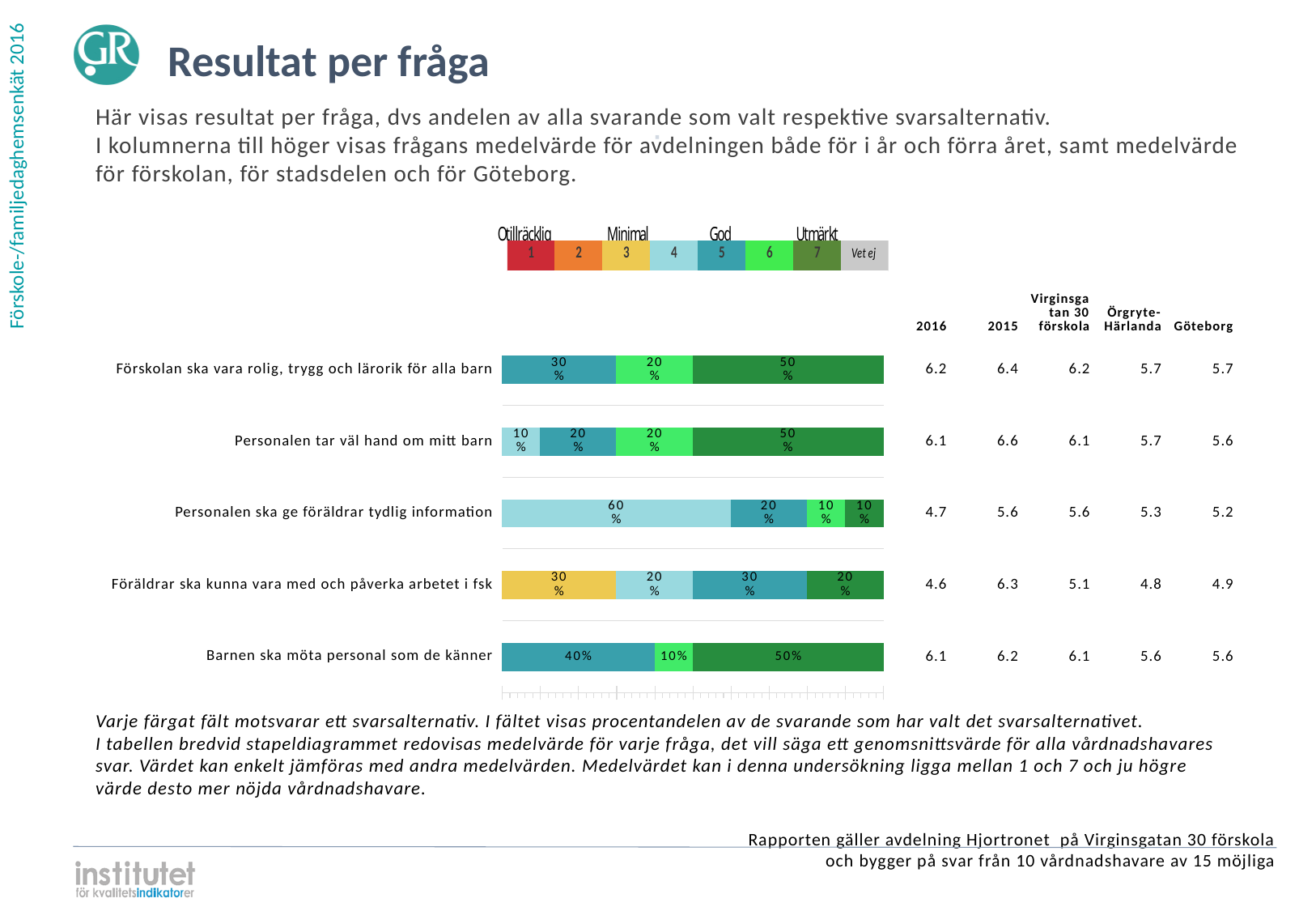
What percentage of respondents chose answer 3 (yellow) for 'Föräldrar ska kunna vara med och påverka arbetet i fsk'? 30% Which is larger for 'Personalen ska ge föräldrar tydlig information': the share for answer 4 or the share for answer 5? Answer 4 How many questions (categories) are shown in the bar chart? 5 What percentage of respondents chose answer 5 (teal) for 'Barnen ska möta personal som de känner'? 40% Which answer option does the dark green colour represent in the legend? 7 How many answer options are shown in the colour legend above the chart, including 'Vet ej'? 8 What percentage of respondents chose answer 7 (dark green) for 'Förskolan ska vara rolig, trygg och lärorik för alla barn'? 50% What is the difference between the answer 7 share and the answer 6 share for 'Barnen ska möta personal som de känner'? 40% What percentage of respondents chose answer 4 (light blue) for 'Personalen ska ge föräldrar tydlig information'? 60% What percentage of respondents chose answer 4 (light blue) for 'Personalen tar väl hand om mitt barn'? 10% What kind of chart is used to show the results per question? Stacked bar chart What is the total of the segments in the bar for 'Personalen tar väl hand om mitt barn'? 100%